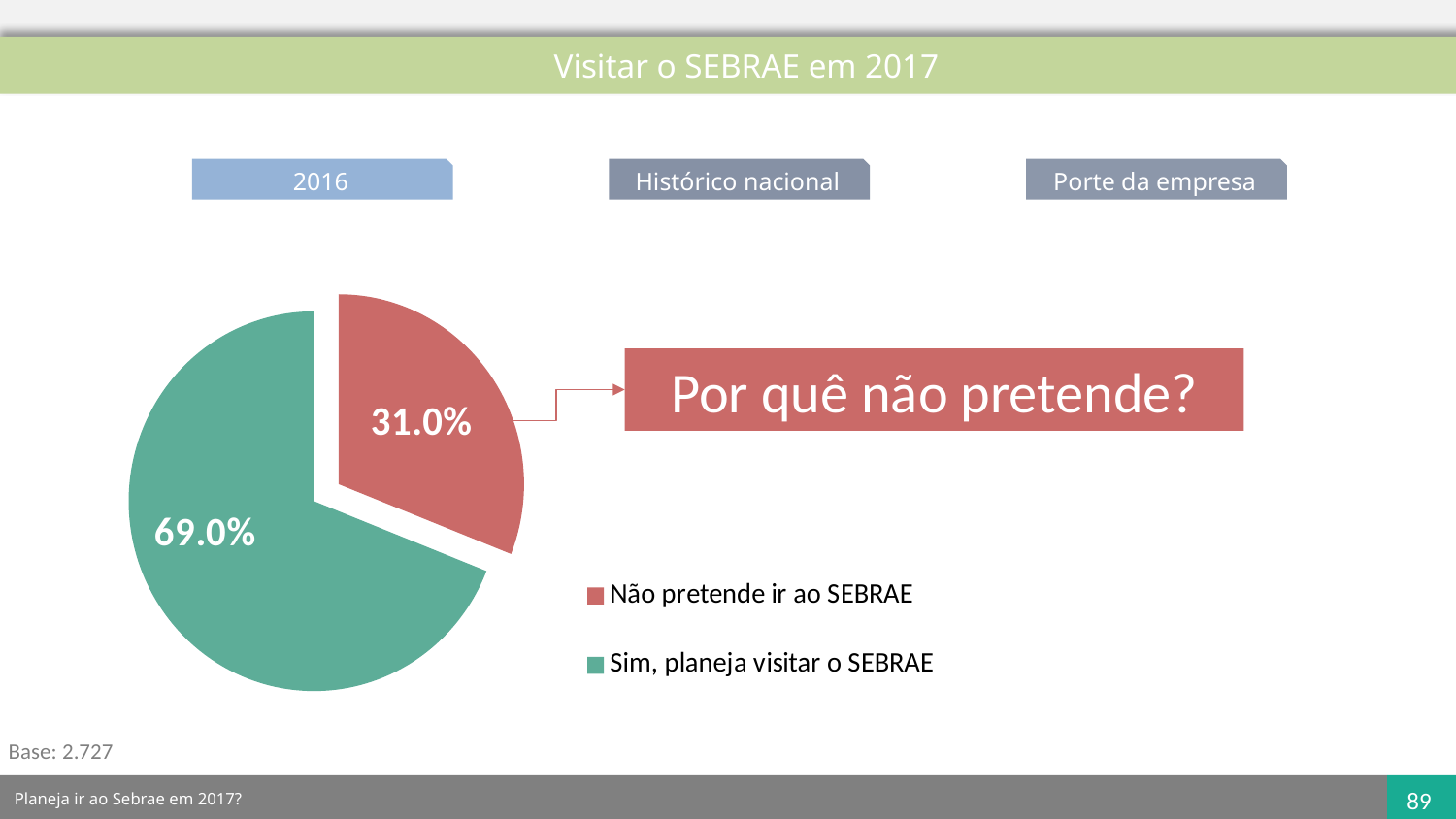
What share of the pie does the "Não pretende ir ao SEBRAE" slice represent? 31.0% Which category has the largest share of the pie? Sim, planeja visitar o SEBRAE What is the difference in percentage points between "Sim, planeja visitar o SEBRAE" and "Não pretende ir ao SEBRAE"? 38.0 percentage points What colour is the slice for "Não pretende ir ao SEBRAE"? Red How many entries does the legend list? 2 What percentage of respondents answered "Não pretende ir ao SEBRAE"? 31.0% Which is larger: the share for "Sim, planeja visitar o SEBRAE" or for "Não pretende ir ao SEBRAE"? Sim, planeja visitar o SEBRAE What is the base (number of respondents) shown on the slide? 2.727 Which category has the smallest share of the pie? Não pretende ir ao SEBRAE What kind of chart is shown on the slide? Pie chart How many slices does the pie chart have? 2 What percentage of respondents answered "Sim, planeja visitar o SEBRAE"? 69.0%